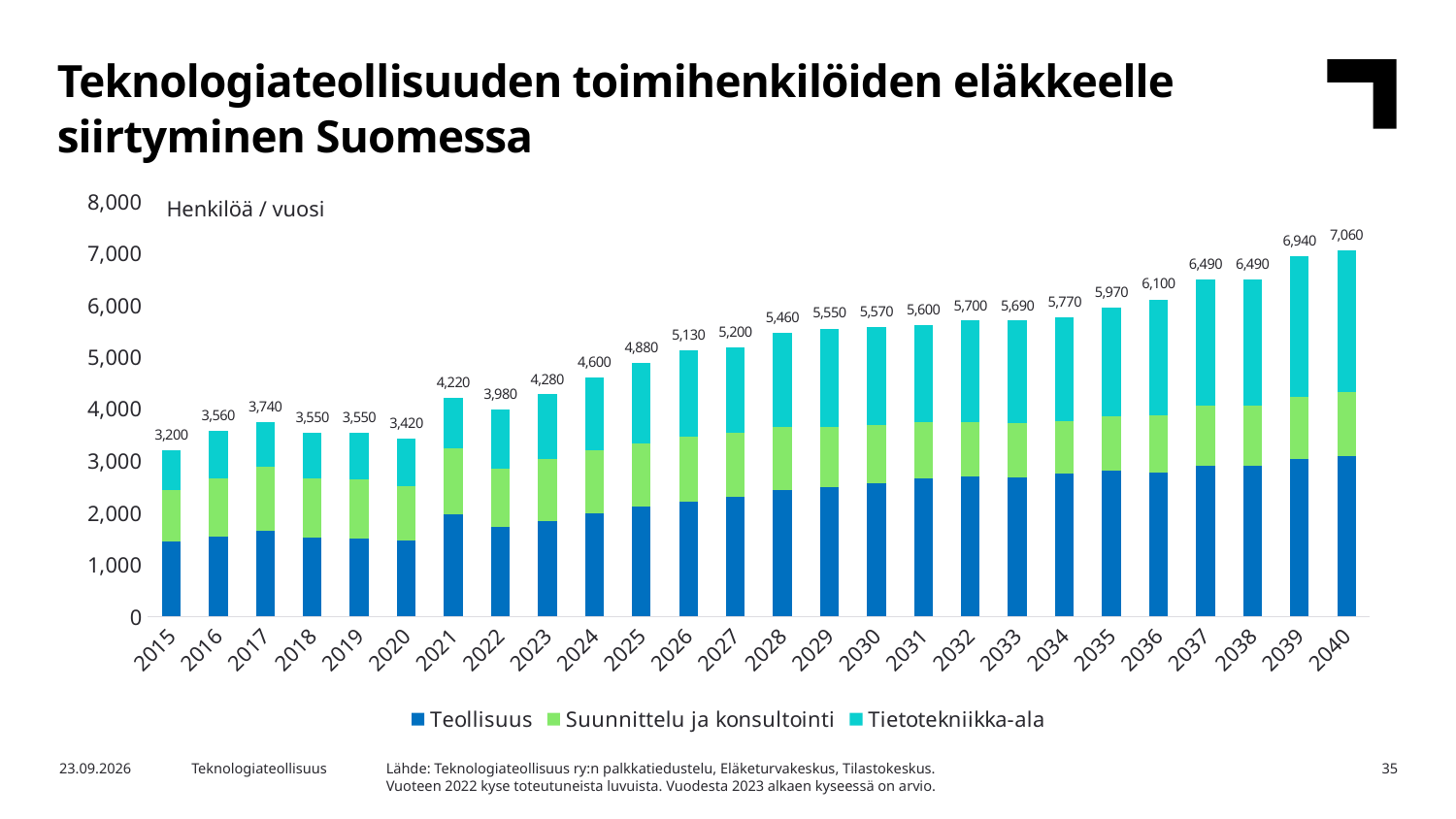
What unit label is shown at the top of the chart? Henkilöä / vuosi What is the total value shown for 2015? 3,200 Which total is larger, 2021 or 2022? 2021 What kind of chart is shown? stacked bar chart Which year has the lowest total? 2015 What is the total value shown for 2040? 7,060 What is the total value shown for 2028? 5,460 What is the difference between the totals for 2040 and 2015? 3,860 How many series does the legend list? 3 Which year has the highest total? 2040 Is the Teollisuus value for 2015 greater or less than 2,000? less How many years are shown on the x axis? 26